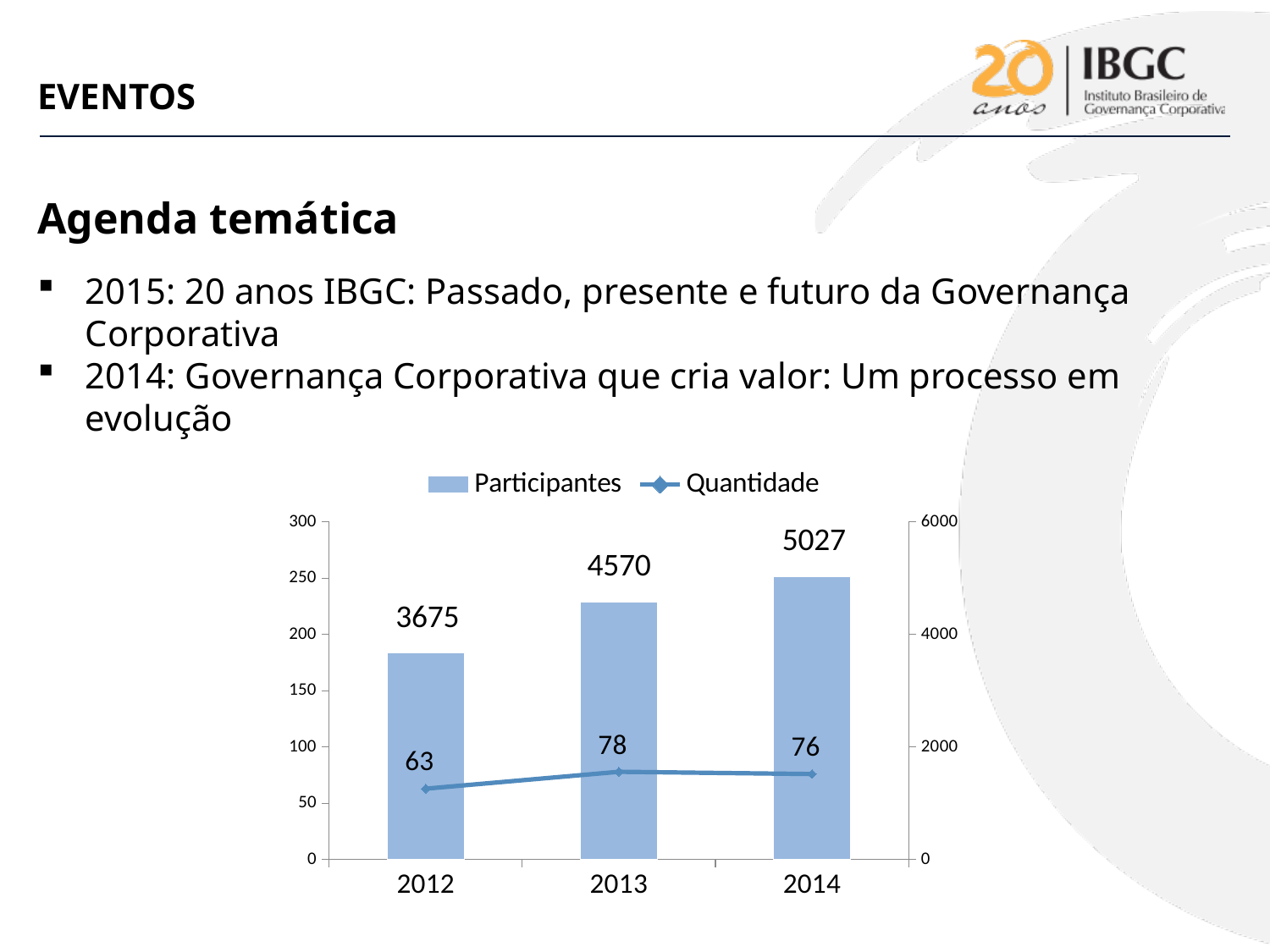
What is the value of Participantes for 2013? 4570 Does the value of Participantes rise or fall from 2012 to 2014? rise What is the difference in Quantidade between 2013 and 2014? 2 What is the value of Quantidade for 2012? 63 Which series is shown as a line with markers? Quantidade How many years are shown on the x axis? 3 Which year has the highest value for Participantes? 2014 Which year has the lowest value for Quantidade? 2012 What is the difference in Participantes between 2014 and 2012? 1352 Which is larger, Quantidade in 2013 or Quantidade in 2012? 2013 How many series does the legend list? 2 What is the value of Participantes for 2014? 5027